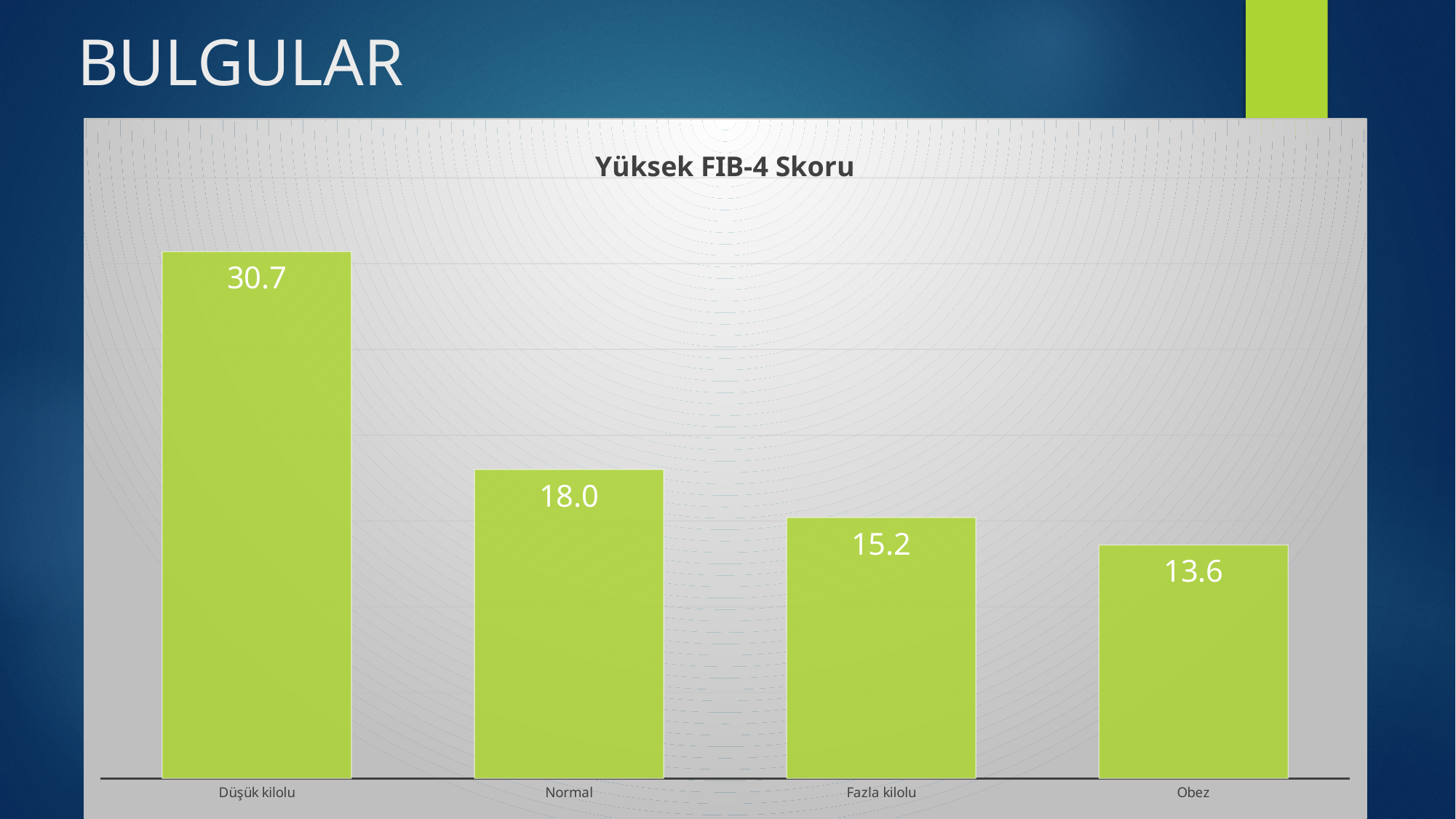
What is the value for Düşük kilolu? 30.7 Do the values rise or fall from left to right across the categories? Fall What is the value for Fazla kilolu? 15.2 Which category has the lowest value? Obez What is the difference between the values for Düşük kilolu and Normal? 12.7 Which category has the highest value? Düşük kilolu How many categories are shown in the chart? 4 What kind of chart is shown on the slide? Bar chart Which is larger, the value for Normal or the value for Fazla kilolu? Normal What is the value for Normal? 18.0 What is the value for Obez? 13.6 What is the difference between the values for Fazla kilolu and Obez? 1.6